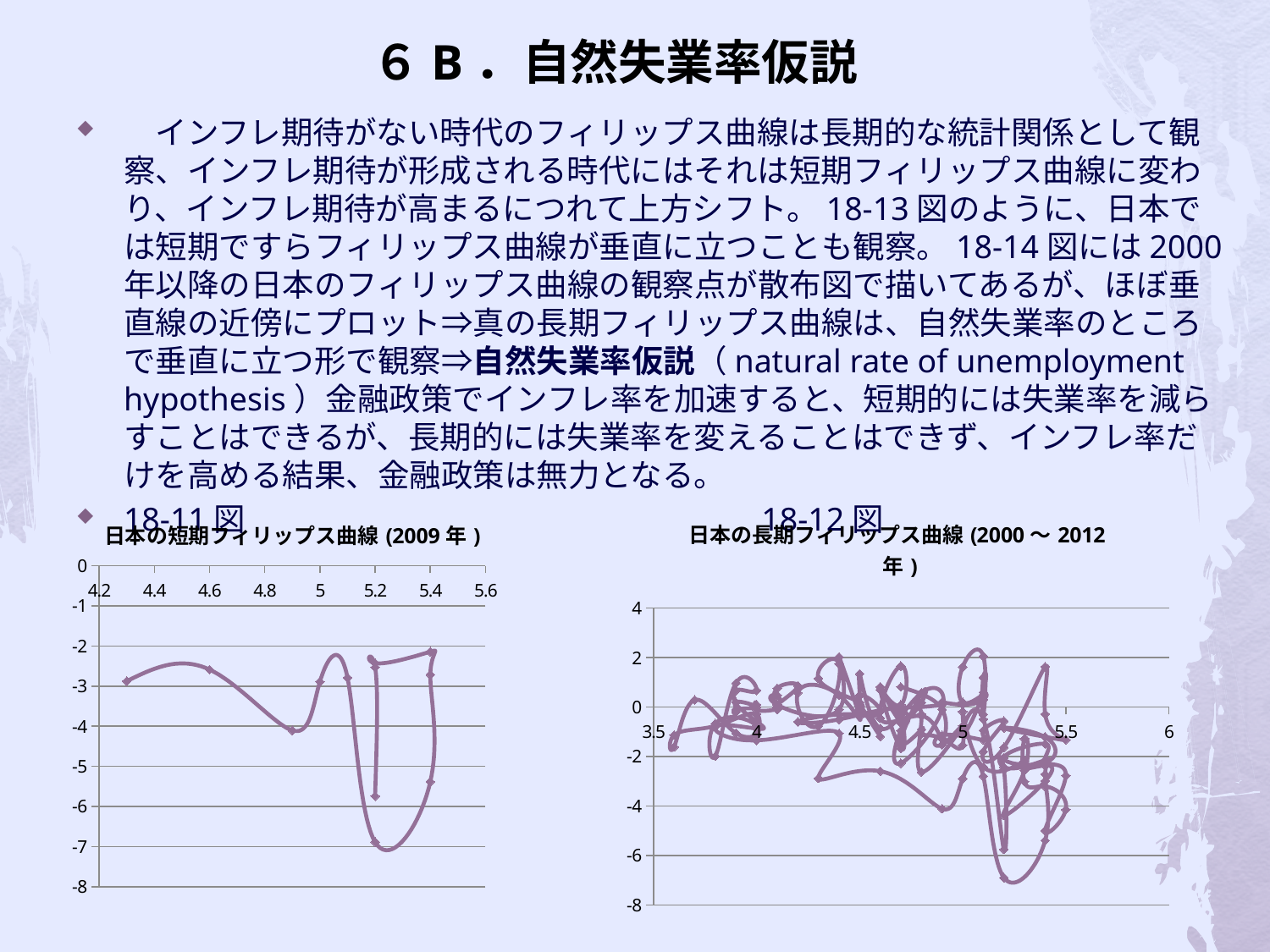
What is the title of the right chart? 日本の長期フィリップス曲線(2000～2012年) In the right chart (日本の長期フィリップス曲線), what is the highest value shown on the horizontal axis? 6 In the right chart (日本の長期フィリップス曲線), is the lowest plotted point greater or less than -6? less What kind of chart is the right chart titled 日本の長期フィリップス曲線(2000～2012年)? scatter chart with smoothed lines In the right chart (日本の長期フィリップス曲線), is the highest plotted point greater or less than 1? greater In the left chart (日本の短期フィリップス曲線), what is the lowest value shown on the vertical axis? -8 What kind of chart is the left chart titled 日本の短期フィリップス曲線(2009年)? scatter chart with smoothed lines In the left chart (日本の短期フィリップス曲線), is the highest plotted point greater or less than -4? greater